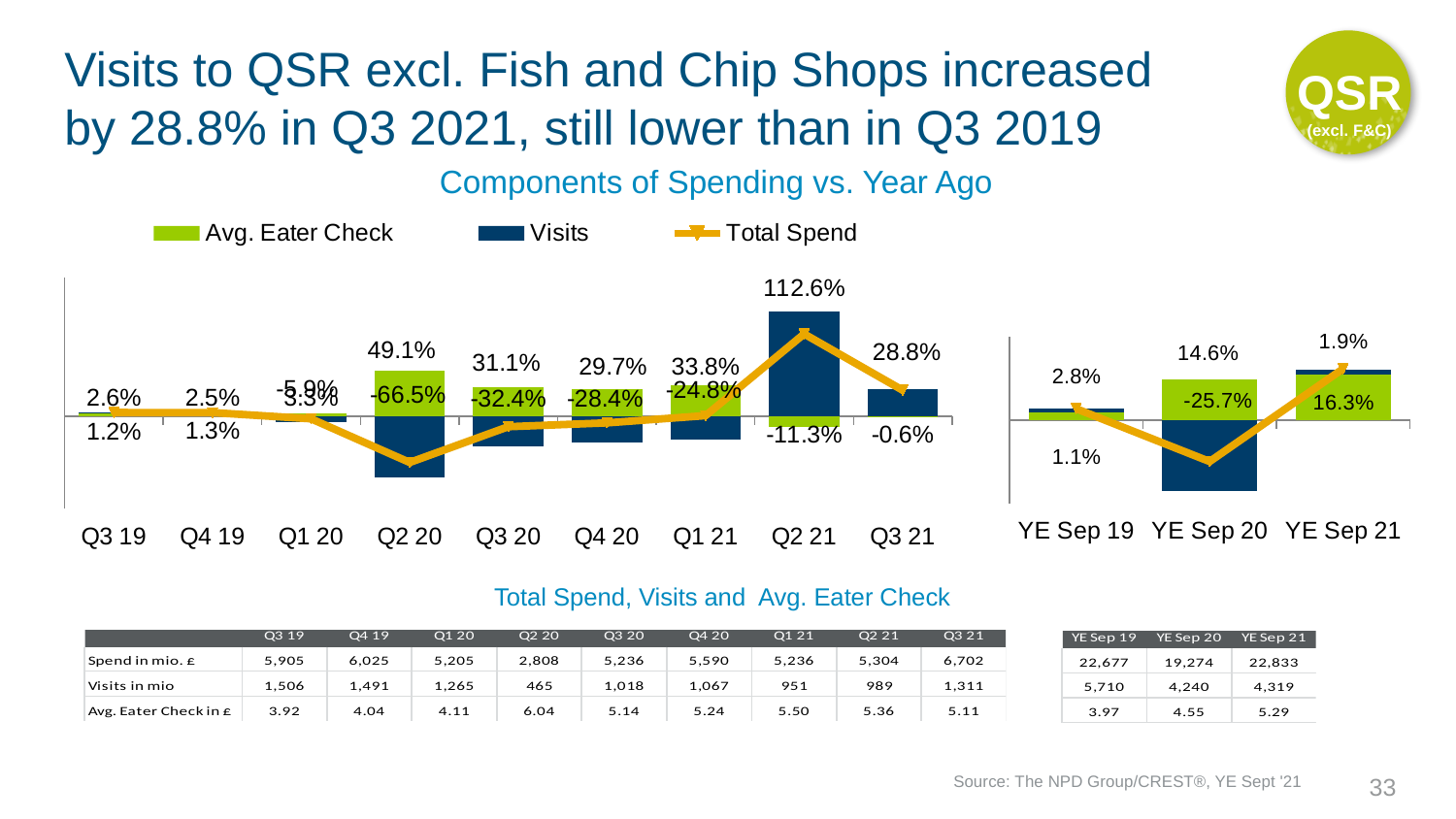
In the quarterly chart, which is larger: the Avg. Eater Check value for Q2 20 or for Q3 20? Q2 20 In the quarterly chart, what is the Avg. Eater Check value for Q2 20? 49.1% In the quarterly chart, which quarter has the lowest Visits value? Q2 20 In the year-ending chart on the right, what is the Visits value for YE Sep 20? -25.7% How many quarters are shown on the x axis of the quarterly 'Components of Spending vs. Year Ago' chart? 9 In the quarterly chart, which quarter has the highest Visits value? Q2 21 How many series does the legend of the 'Components of Spending vs. Year Ago' chart list? 3 In the quarterly chart, what is the Visits value for Q2 21? 112.6% In the quarterly chart, what is the Visits value for Q2 20? -66.5% How many periods are shown on the x axis of the year-ending chart on the right? 3 What kind of chart is the quarterly 'Components of Spending vs. Year Ago' chart? Bar chart with a line In the quarterly chart, what is the Visits value for Q3 21? 28.8%